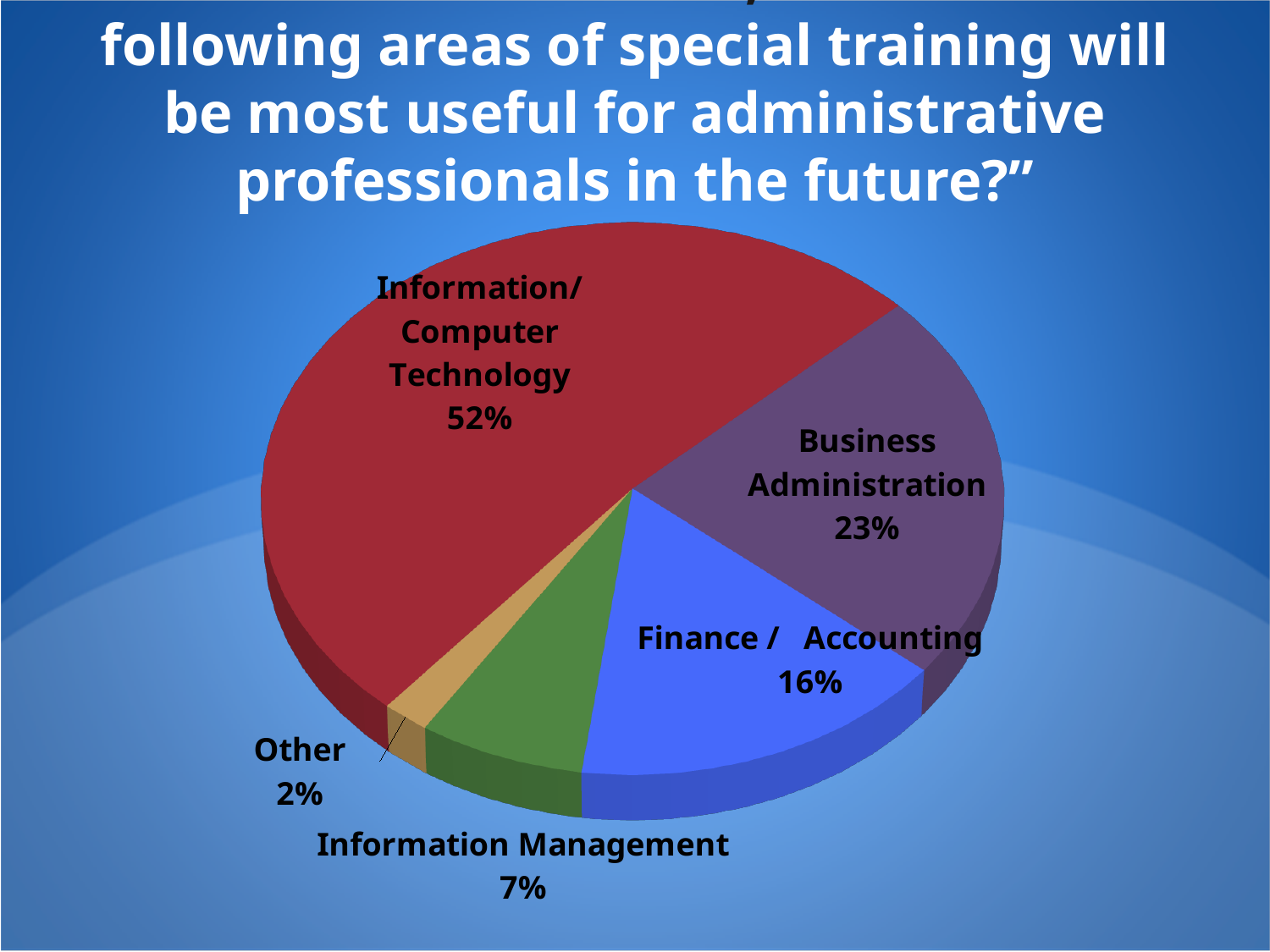
What share of the pie does Business Administration have? 23% What kind of chart is shown on the slide? Pie chart What share of the pie does Other have? 2% What is the difference in percentage points between Business Administration and Finance / Accounting? 7 What colour is the Information/Computer Technology slice? Red How many slices does the pie chart have? 5 What share of the pie does Information Management have? 7% Which area has the largest share of the pie? Information/Computer Technology Which area has the smallest share of the pie? Other What share of the pie does Information/Computer Technology have? 52% Which is larger, Information Management or Finance / Accounting? Finance / Accounting What share of the pie does Finance / Accounting have? 16%